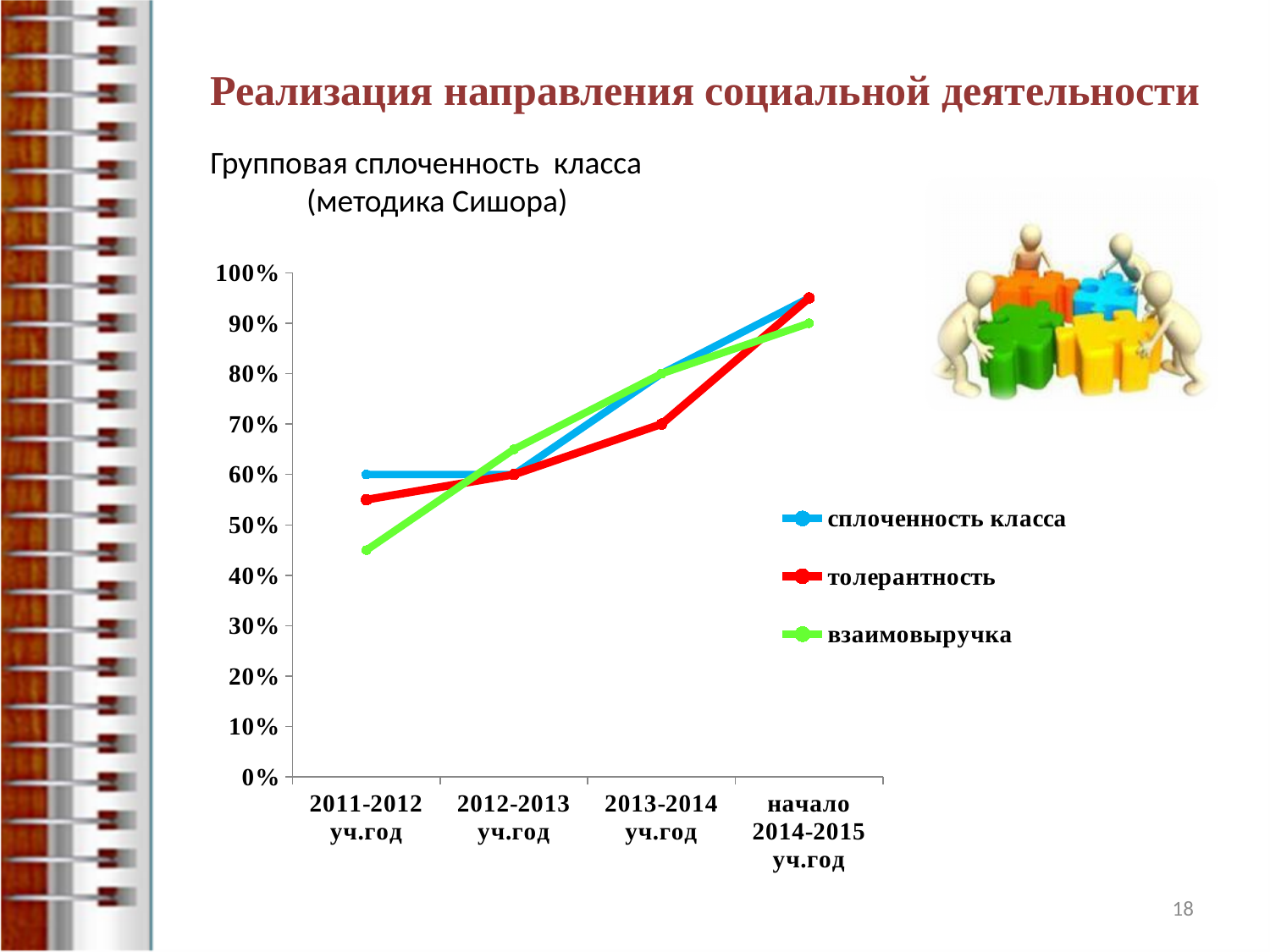
What kind of chart is shown on the slide? line chart How many series does the legend list? 3 Is the value for толерантность at начало 2014-2015 уч.год greater or less than 90%? greater What is the value for взаимовыручка in 2013-2014 уч.год? 80% What is the value for сплоченность класса in 2011-2012 уч.год? 60% Which series has the lowest value in 2011-2012 уч.год? взаимовыручка What is the value for толерантность in 2013-2014 уч.год? 70% How many points along the x axis does the chart have? 4 Which colour is used for the сплоченность класса line? blue Does the value for толерантность rise or fall from 2011-2012 уч.год to начало 2014-2015 уч.год? rise Is the value for взаимовыручка in 2011-2012 уч.год greater or less than 50%? less What is the value for взаимовыручка at начало 2014-2015 уч.год? 90%